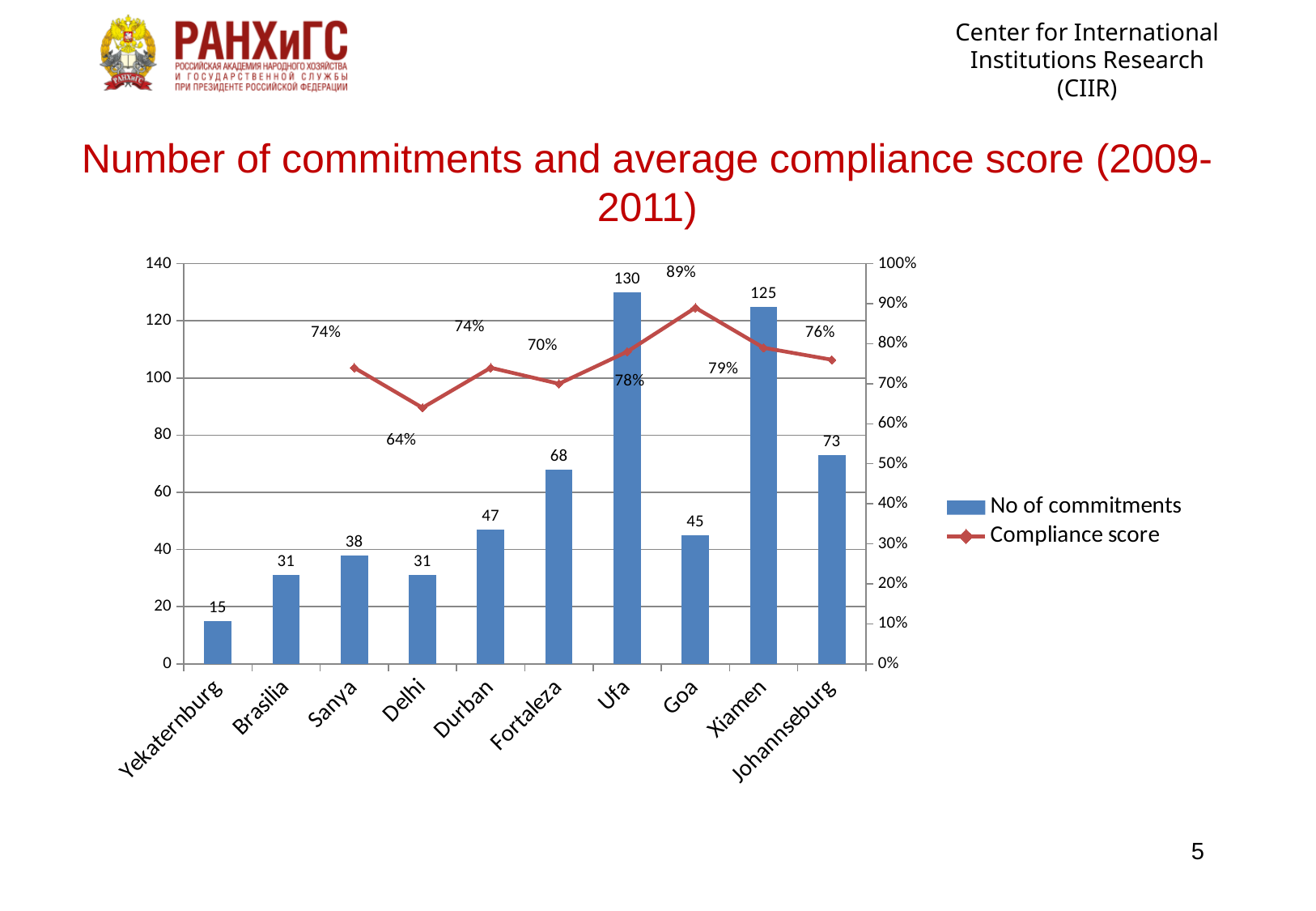
What is the compliance score for Goa? 89% How many categories are shown on the x axis? 10 Which category has the lowest compliance score? Delhi How many series does the legend list? 2 What is the number of commitments for Fortaleza? 68 What is the compliance score for Delhi? 64% What kind of chart is used for the No of commitments series? Bar chart Which category has the highest number of commitments? Ufa What is the difference in number of commitments between Ufa and Xiamen? 5 Which has more commitments, Durban or Goa? Durban What is the number of commitments for Ufa? 130 Which category has the lowest number of commitments? Yekaternburg